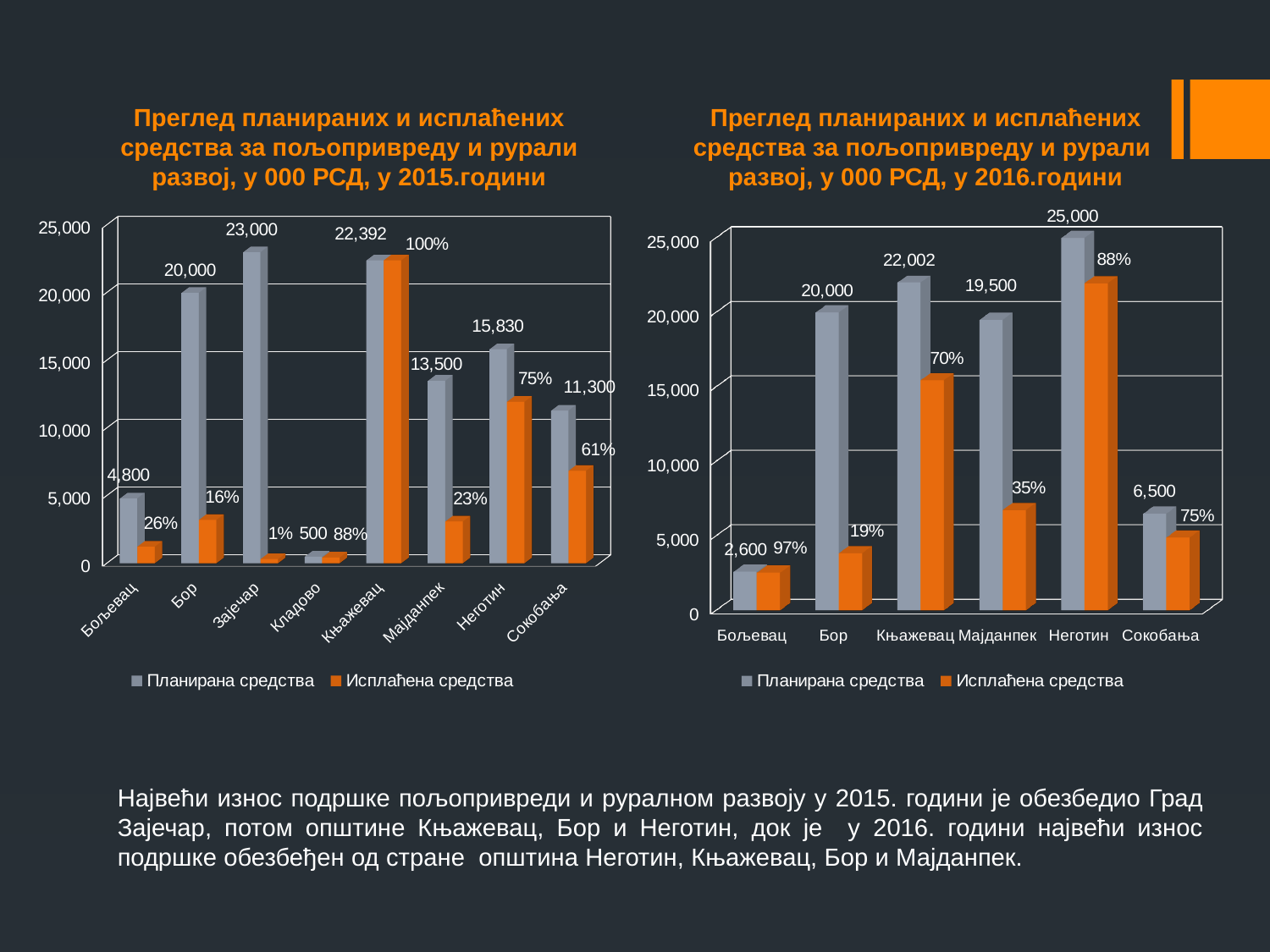
How many municipalities are shown on the x axis of the 2015 chart (left)? 8 How many series does the legend of the 2016 chart (right) list? 2 In the 2015 chart (left), what is the difference between the planned amounts for Зајечар and Бор? 3,000 In the 2015 chart (left), which municipality has the lowest planned amount? Кладово In the 2016 chart (right), what percentage label is shown on the paid bar for Бољевац? 97% In the 2016 chart (right), what is the planned amount for Неготин? 25,000 In the 2016 chart (right), which has a larger planned amount, Књажевац or Мајданпек? Књажевац In the 2015 chart (left), what percentage label is shown on the paid (Исплаћена средства) bar for Књажевац? 100% In the 2016 chart (right), which municipality has the highest planned amount? Неготин In the 2016 chart (right), is the paid amount for Бор greater or less than 5,000? less In the 2015 chart (left), what is the planned amount (Планирана средства) for Зајечар? 23,000 What type of chart is the 2016 chart (right)? Bar chart